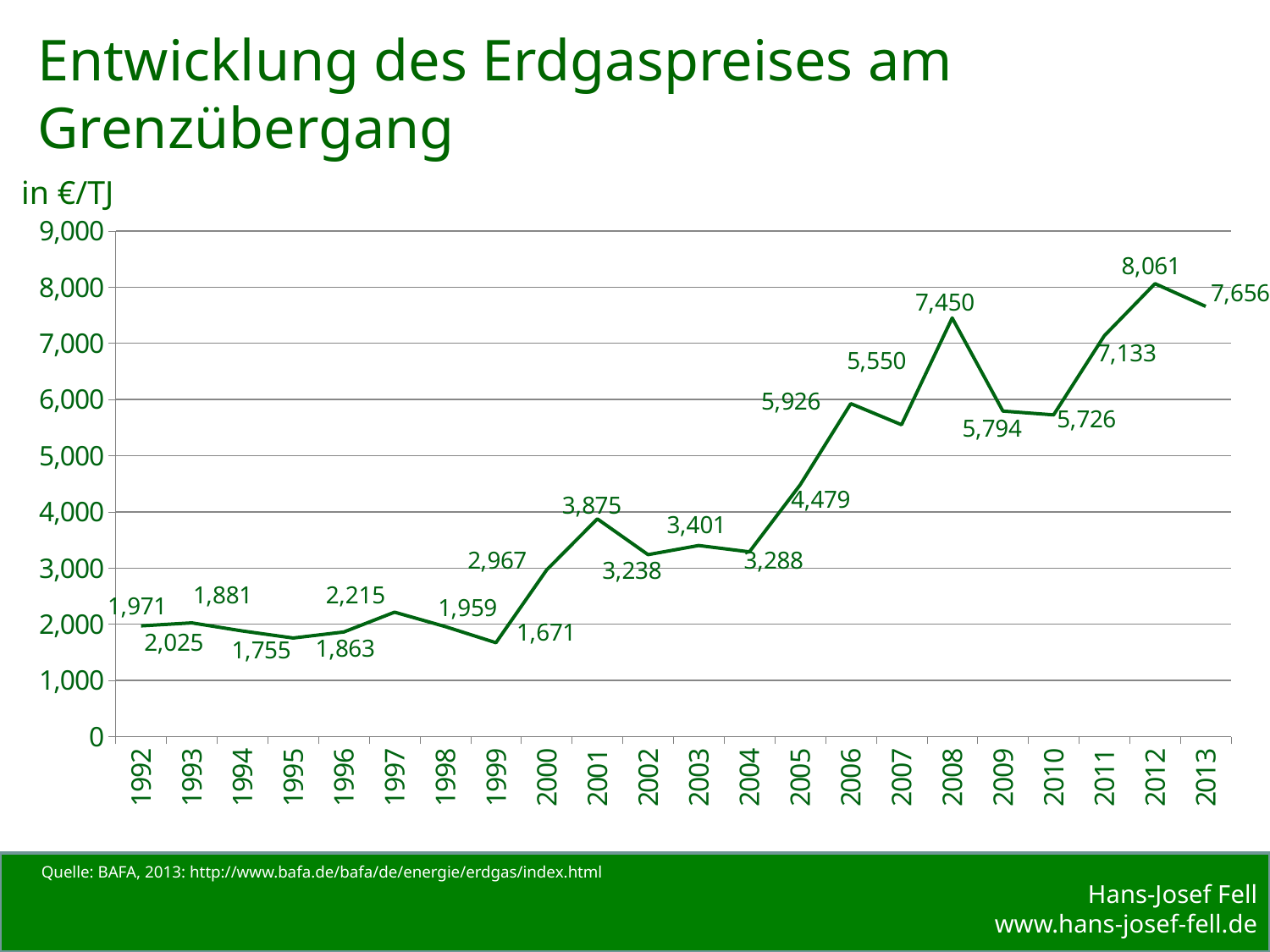
How many years are plotted on the x axis? 22 Which year has the lowest value? 1999 What is the difference between the values for 2008 and 2007? 1,900 What is the value for 2008? 7,450 What is the value for 2012? 8,061 Which year has the highest value? 2012 What kind of chart is shown? line chart What unit is given for the values on the chart? €/TJ Is the value for 2005 greater or less than 4,000? greater What is the value for 1999? 1,671 What is the difference between the values for 2012 and 2013? 405 Which is larger, the value for 2006 or the value for 2007? 2006